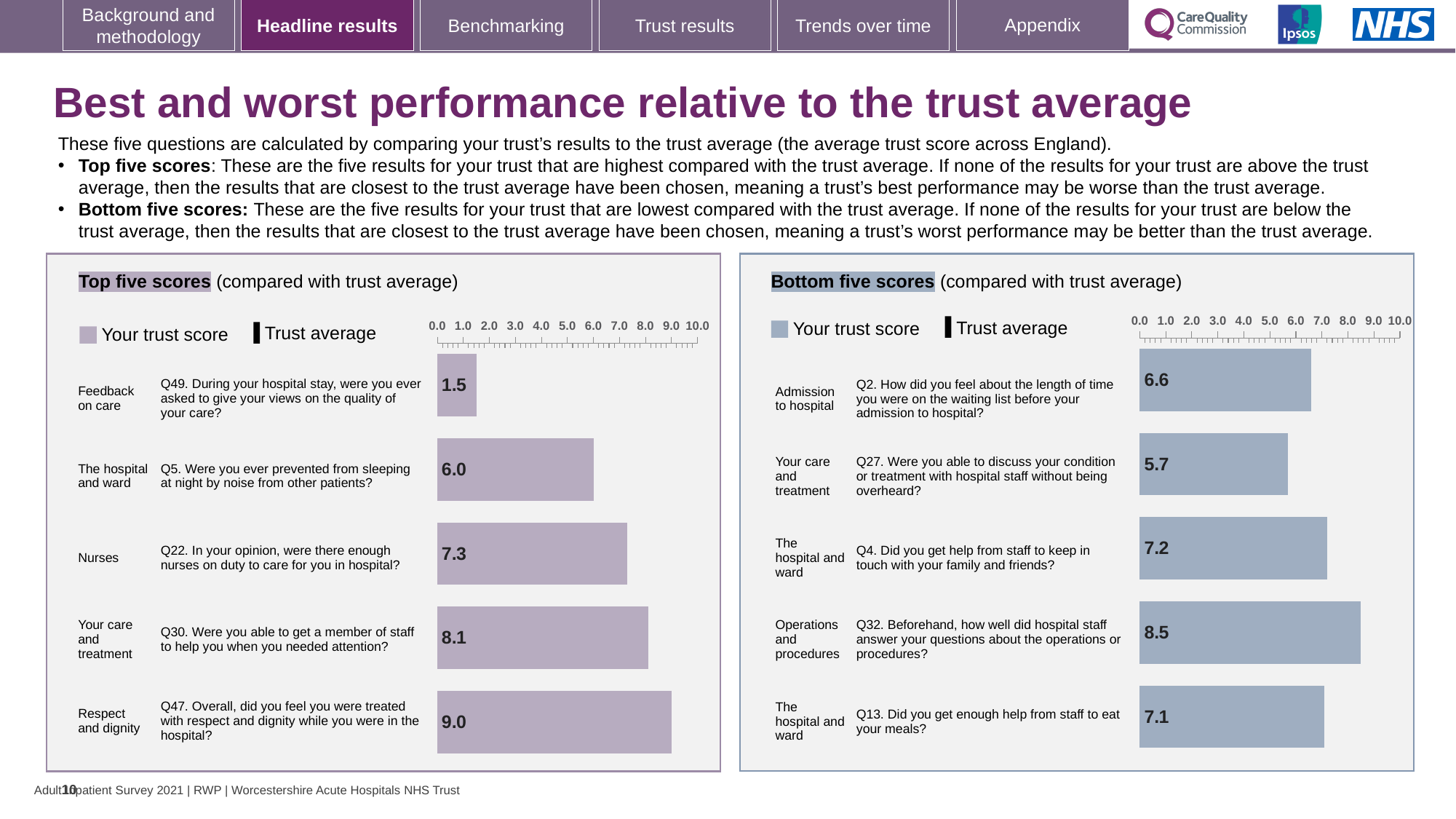
In the 'Bottom five scores' chart, which has the larger trust score, Q2 or Q4? Q4 In the 'Top five scores' chart, what is the difference between the trust scores for Q30 and Q5? 2.1 In the 'Bottom five scores' chart, what is the difference between the trust scores for Q4 and Q13? 0.1 In the 'Bottom five scores' chart, what is the trust score for Q32 (staff answering questions about operations or procedures)? 8.5 In the 'Bottom five scores' chart, which question has the lowest trust score? Q27 What kind of chart is the 'Bottom five scores' chart? Bar chart In the 'Bottom five scores' chart, what is the trust score for Q27 (discussing your condition without being overheard)? 5.7 In the 'Top five scores' chart, what is the trust score for Q47 (treated with respect and dignity)? 9.0 In the 'Top five scores' chart, what is the trust score for Q49 (asked to give your views on the quality of your care)? 1.5 How many questions are plotted in the 'Top five scores' chart? 5 How many entries does the legend of the 'Top five scores' chart list? 2 In the 'Top five scores' chart, which question has the highest trust score? Q47